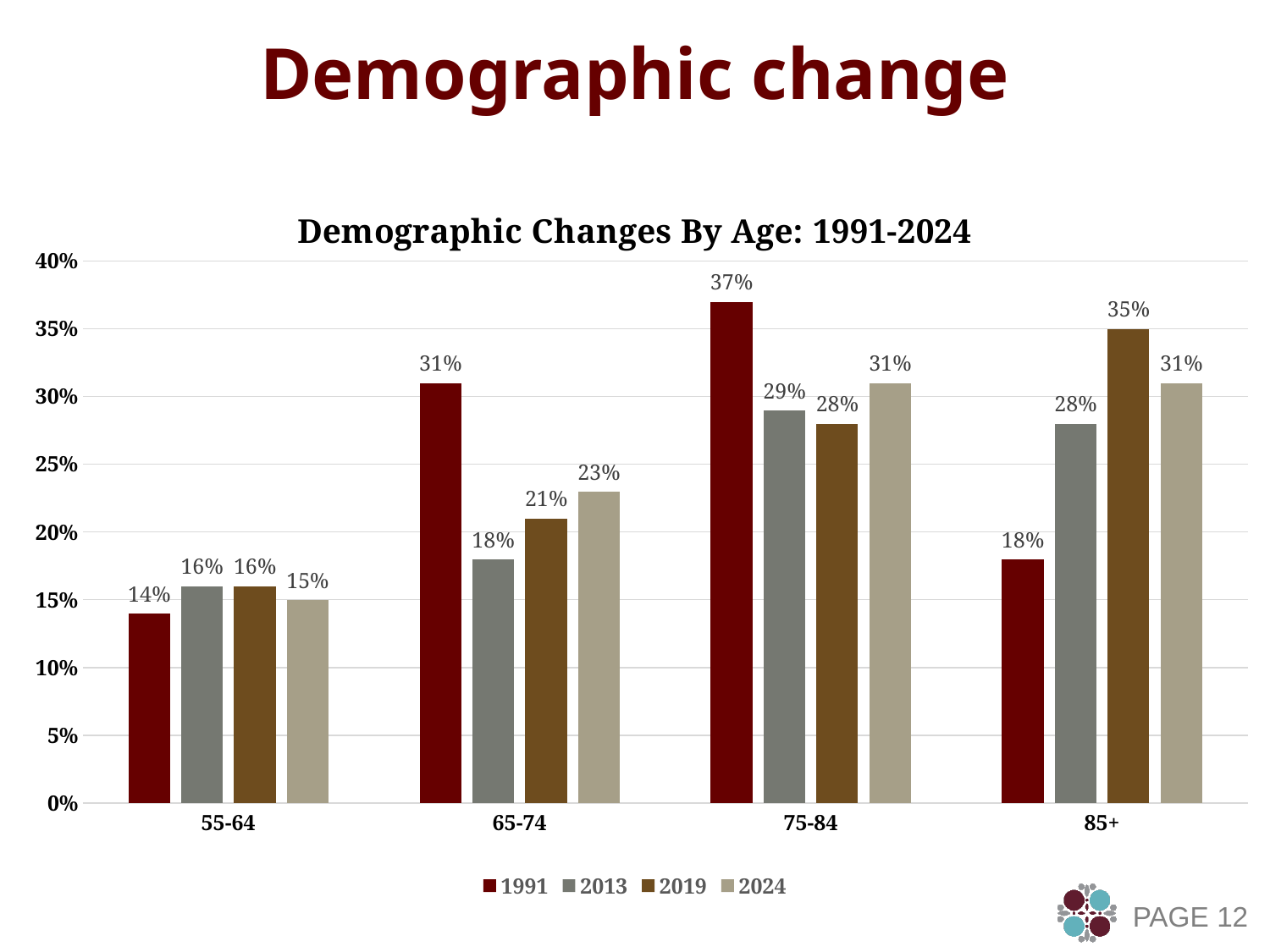
Which age group has the highest value in 1991? 75-84 What is the value for the 75-84 age group in 1991? 37% How many series does the legend list? 4 How many age groups are shown on the x axis? 4 What is the value for the 65-74 age group in 2024? 23% What is the title of the chart? Demographic Changes By Age: 1991-2024 What kind of chart is shown on the slide? Bar chart What is the value for the 85+ age group in 2019? 35% Which series is shown in dark red in the legend? 1991 Which is larger for the 65-74 age group: the 2013 value or the 2019 value? 2019 Which age group has the lowest value in 2024? 55-64 What is the difference between the 1991 and 2024 values for the 85+ age group? 13%